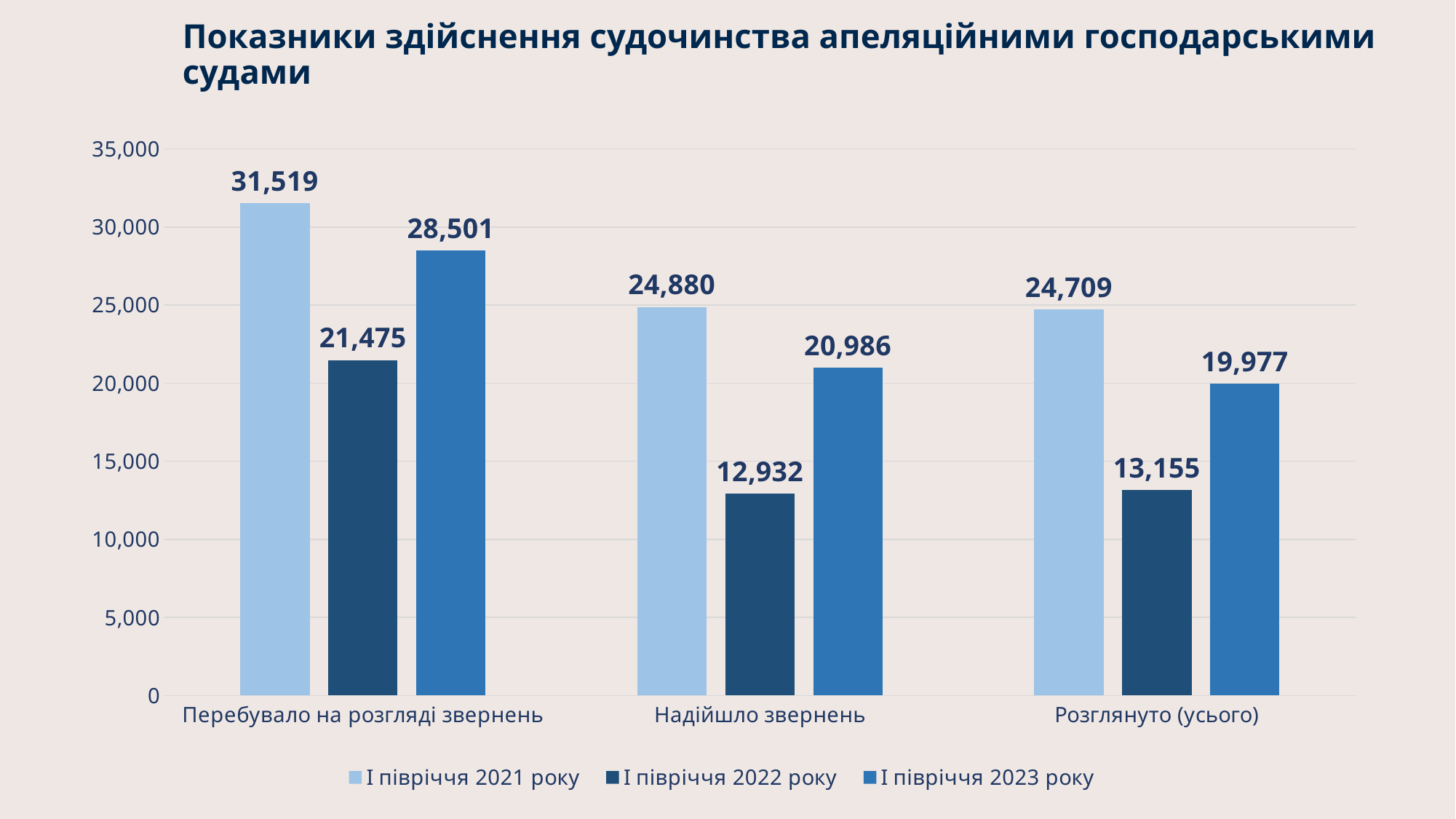
What type of chart is shown on the slide? Bar chart What is the title of the chart? Показники здійснення судочинства апеляційними господарськими судами What is the value for "І півріччя 2022 року" in the category "Надійшло звернень"? 12,932 Which category has the highest value for the series "І півріччя 2023 року"? Перебувало на розгляді звернень What is the value for "І півріччя 2023 року" in the category "Розглянуто (усього)"? 19,977 How many series does the legend list? 3 What is the difference between the "І півріччя 2021 року" and "І півріччя 2022 року" values in the category "Перебувало на розгляді звернень"? 10,044 Which is larger in the category "Надійшло звернень": the value for "І півріччя 2021 року" or for "І півріччя 2023 року"? І півріччя 2021 року What is the value for "І півріччя 2021 року" in the category "Перебувало на розгляді звернень"? 31,519 Is the value for "І півріччя 2022 року" in the category "Розглянуто (усього)" greater or less than 15,000? less Which category has the lowest value for the series "І півріччя 2022 року"? Надійшло звернень How many categories are shown on the x axis? 3